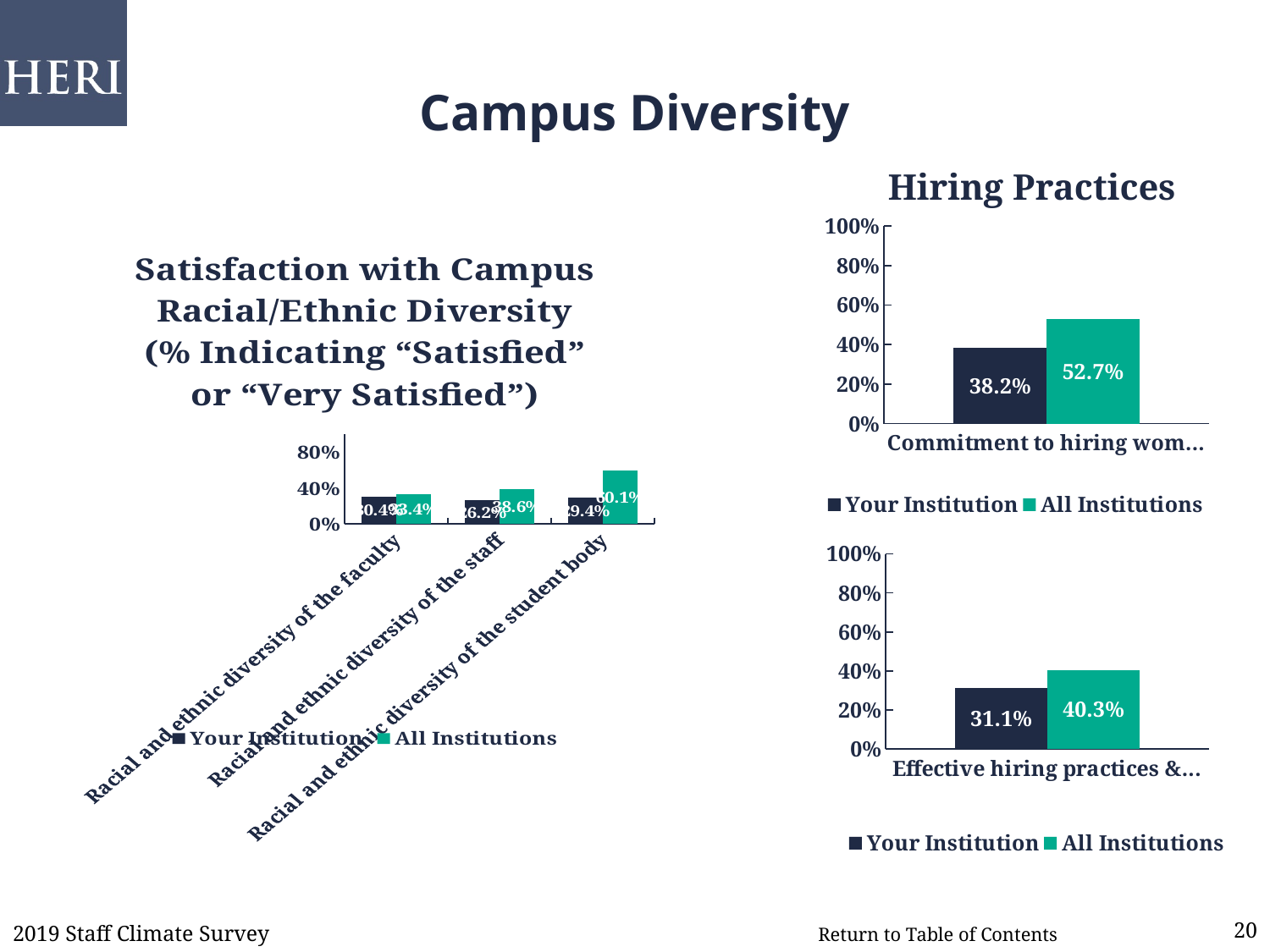
In the bottom-right chart ('Effective hiring practices &...'), what is the value for All Institutions? 40.3% In the top-right Hiring Practices chart, is the value for All Institutions greater or less than 40%? greater In the top-right Hiring Practices chart, what is the value for Your Institution for 'Commitment to hiring wom...'? 38.2% In the bottom-right chart ('Effective hiring practices &...'), what is the value for Your Institution? 31.1% In the bottom-right chart ('Effective hiring practices &...'), what is the difference between the All Institutions and Your Institution values? 9.2 percentage points In the left chart 'Satisfaction with Campus Racial/Ethnic Diversity', how many categories are shown on the x axis? 3 In the top-right Hiring Practices chart, what is the value for All Institutions for 'Commitment to hiring wom...'? 52.7% What kind of chart is the left chart 'Satisfaction with Campus Racial/Ethnic Diversity'? bar chart In the bottom-right chart ('Effective hiring practices &...'), which series has the larger value, Your Institution or All Institutions? All Institutions In the left chart 'Satisfaction with Campus Racial/Ethnic Diversity', for 'Racial and ethnic diversity of the student body', which series is higher, Your Institution or All Institutions? All Institutions In the top-right Hiring Practices chart, what is the difference between the All Institutions and Your Institution values? 14.5 percentage points In the left chart 'Satisfaction with Campus Racial/Ethnic Diversity', how many series does the legend list? 2